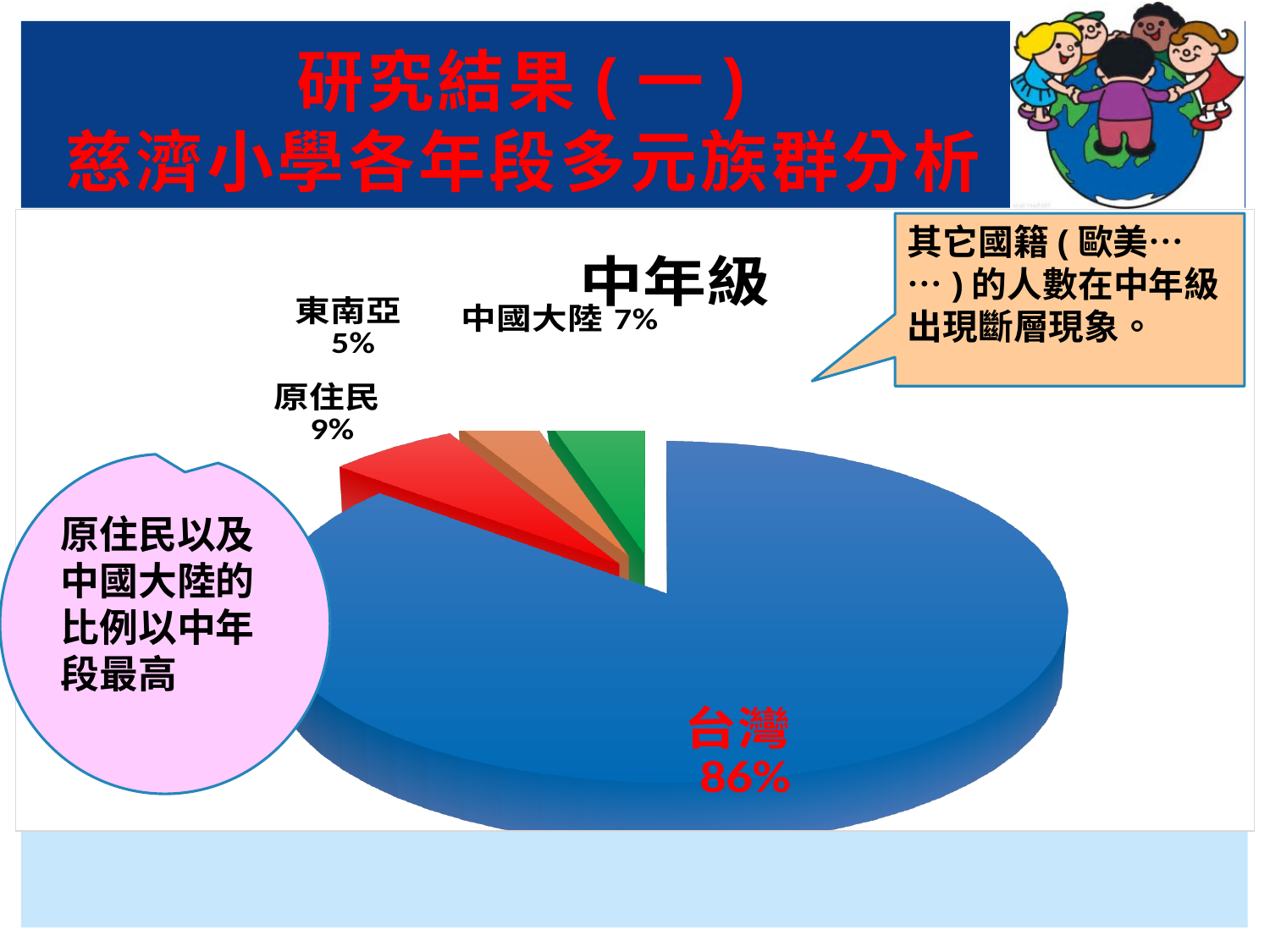
What colour is the 台灣 slice of the pie? blue What share of the pie does 東南亞 have? 5% What share of the pie does 台灣 have? 86% What is the difference in percentage points between the 台灣 share and the 原住民 share? 77 What is the title of the pie chart? 中年級 How many slices does the pie chart have? 4 Which category has the largest slice of the pie? 台灣 Which category has the smallest slice of the pie? 東南亞 What share of the pie does 中國大陸 have? 7% What kind of chart is shown on the slide? pie chart Which is larger, the share for 原住民 or the share for 中國大陸? 原住民